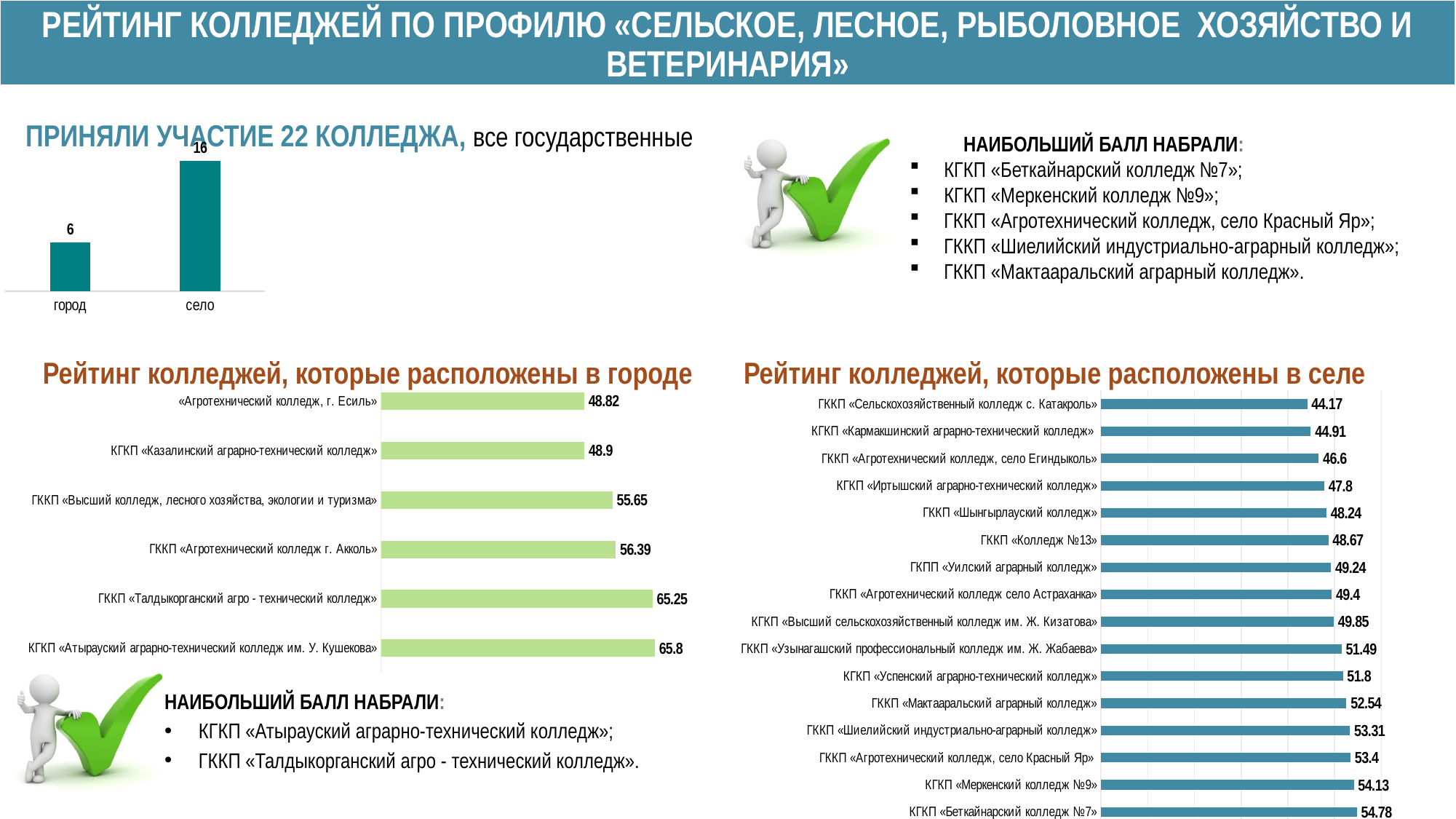
In the chart «Рейтинг колледжей, которые расположены в городе», what is the value for ГККП «Талдыкорганский агро - технический колледж»? 65.25 In the small bar chart at the top left, what is the difference between the values for «село» and «город»? 10 In the chart «Рейтинг колледжей, которые расположены в городе», which college has the lowest value? «Агротехнический колледж, г. Есиль» In the chart «Рейтинг колледжей, которые расположены в городе», how many colleges are shown? 6 In the small bar chart at the top left, what is the value for «село»? 16 In the chart «Рейтинг колледжей, которые расположены в селе», which college has the highest value? КГКП «Беткайнарский колледж №7» In the chart «Рейтинг колледжей, которые расположены в селе», how many colleges are shown? 16 In the chart «Рейтинг колледжей, которые расположены в городе», which college has the highest value? КГКП «Атырауский аграрно-технический колледж им. У. Кушекова» In the small bar chart at the top left, what is the value for «город»? 6 In the chart «Рейтинг колледжей, которые расположены в селе», which college has the lowest value? ГККП «Сельскохозяйственный колледж с. Катакроль» In the chart «Рейтинг колледжей, которые расположены в селе», what is the value for КГКП «Меркенский колледж №9»? 54.13 What kind of chart is «Рейтинг колледжей, которые расположены в селе»? Bar chart